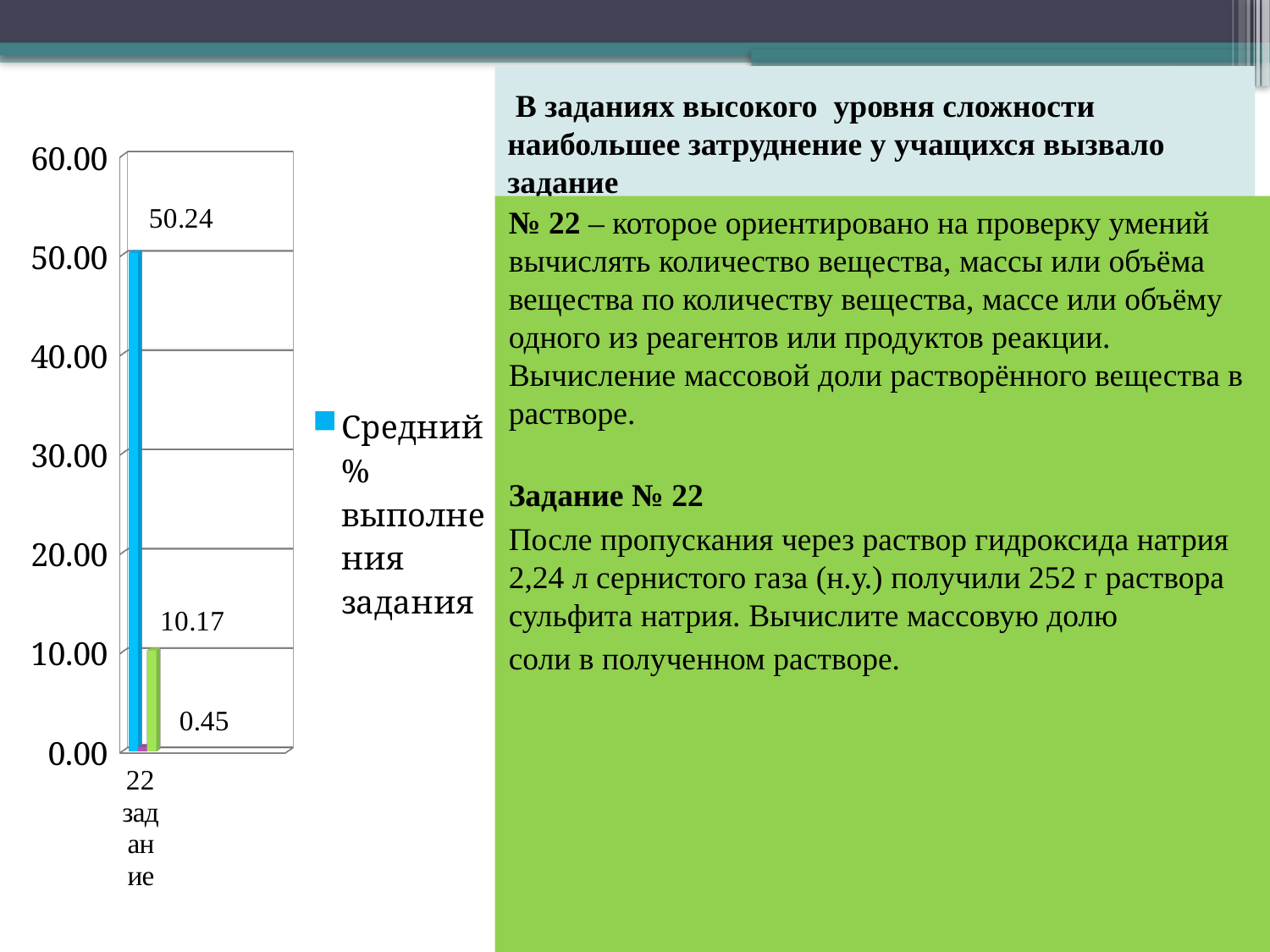
Which bar has the lowest value on the chart? the magenta bar (0.45) Is the value of the blue bar greater or less than 40.00? greater What is the value of the blue bar for "22 задание"? 50.24 What is the legend entry shown next to the chart? Средний % выполнения задания How many categories are shown on the x axis of the chart? 1 Which is larger, the blue bar or the green bar? the blue bar What kind of chart is shown on the slide? bar chart What is the value of the magenta bar for "22 задание"? 0.45 What is the difference between the green bar (10.17) and the magenta bar (0.45)? 9.72 What is the value of the green bar for "22 задание"? 10.17 Which bar has the highest value on the chart? the blue bar (50.24) What is the difference between the blue bar (50.24) and the green bar (10.17)? 40.07